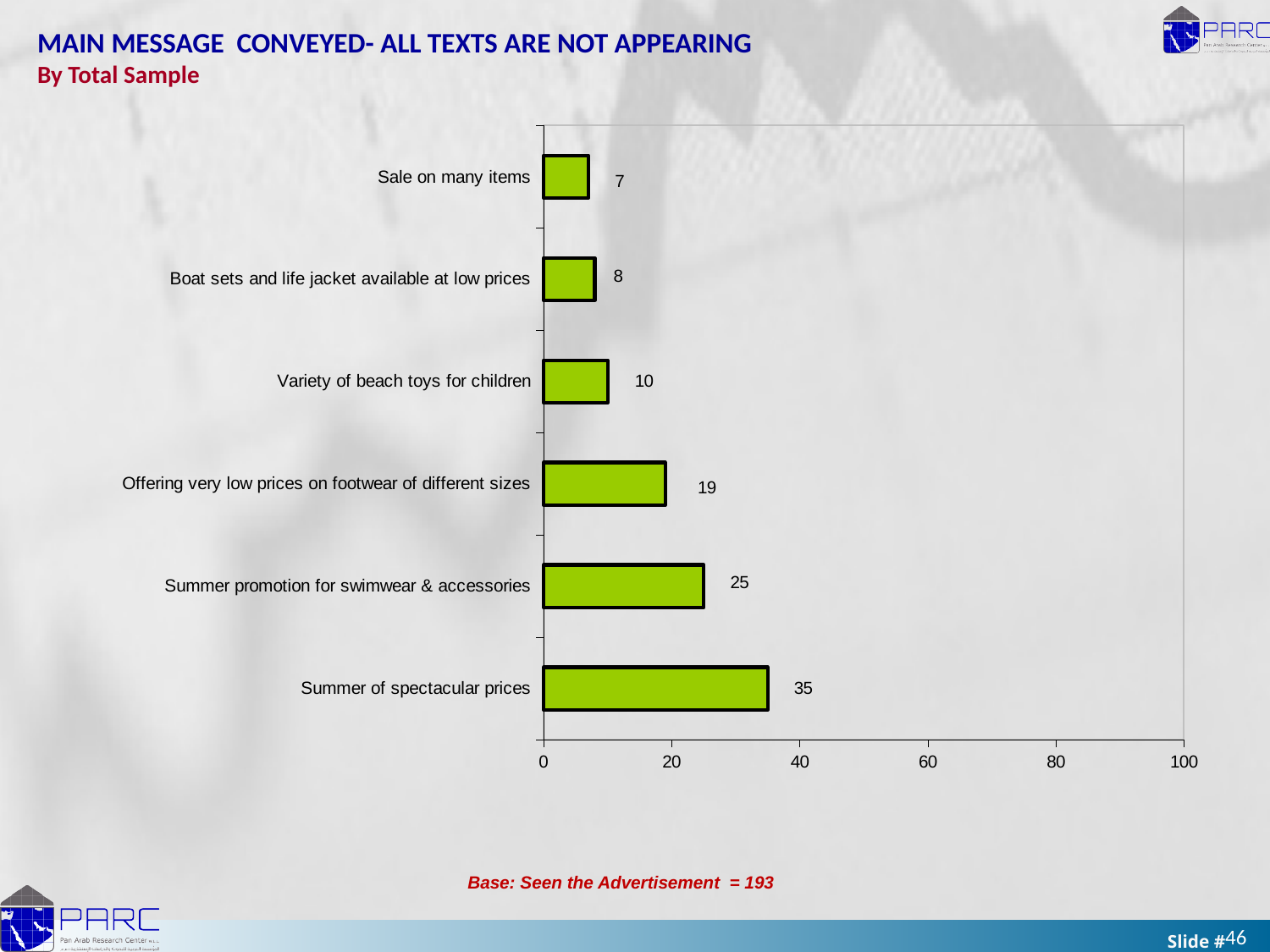
Which category has the lowest value? Sale on many items Is the value for "Summer promotion for swimwear & accessories" greater or less than 20? greater What is the value for "Summer of spectacular prices"? 35 What is the base (sample size) stated below the chart? 193 Which category has the highest value? Summer of spectacular prices Which is larger: the value for "Boat sets and life jacket available at low prices" or the value for "Variety of beach toys for children"? Variety of beach toys for children What kind of chart is shown on the slide? bar chart What is the difference between the values for "Summer of spectacular prices" and "Summer promotion for swimwear & accessories"? 10 What is the value for "Variety of beach toys for children"? 10 How many categories are shown in the chart? 6 What is the value for "Offering very low prices on footwear of different sizes"? 19 What is the maximum value shown on the x axis? 100